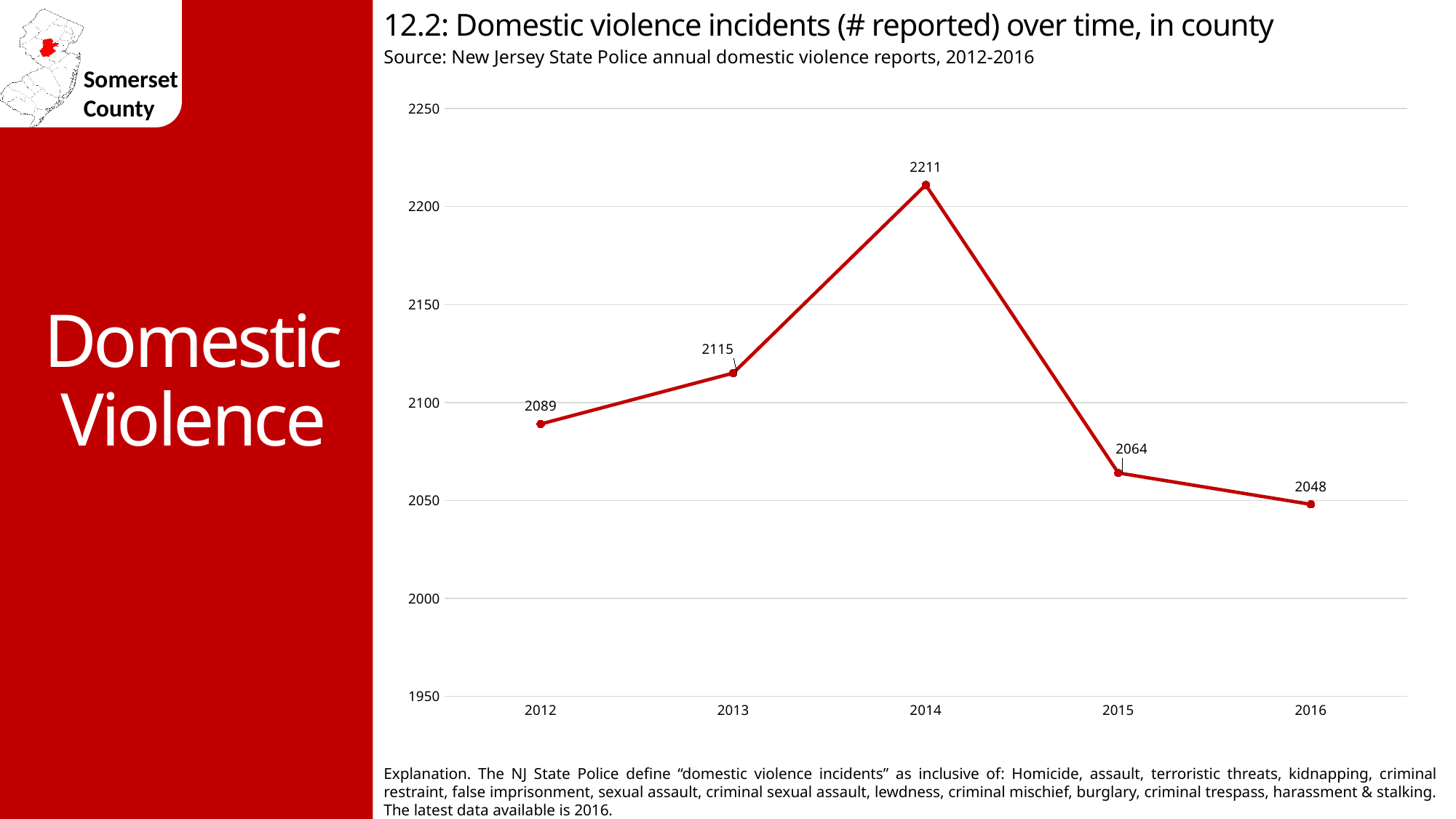
How many years are plotted on the chart? 5 Which year had more reported incidents, 2013 or 2015? 2013 How many domestic violence incidents were reported in 2012? 2089 Which year had the lowest number of reported domestic violence incidents? 2016 How many domestic violence incidents were reported in 2016? 2048 What is the difference between the number of incidents in 2015 and in 2016? 16 How many domestic violence incidents were reported in 2014? 2211 Which year had the highest number of reported domestic violence incidents? 2014 Did the number of reported incidents rise or fall from 2014 to 2016? fall What kind of chart is shown on the slide? line chart Is the value for 2012 greater or less than 2100? less What is the difference between the number of incidents in 2014 and in 2013? 96